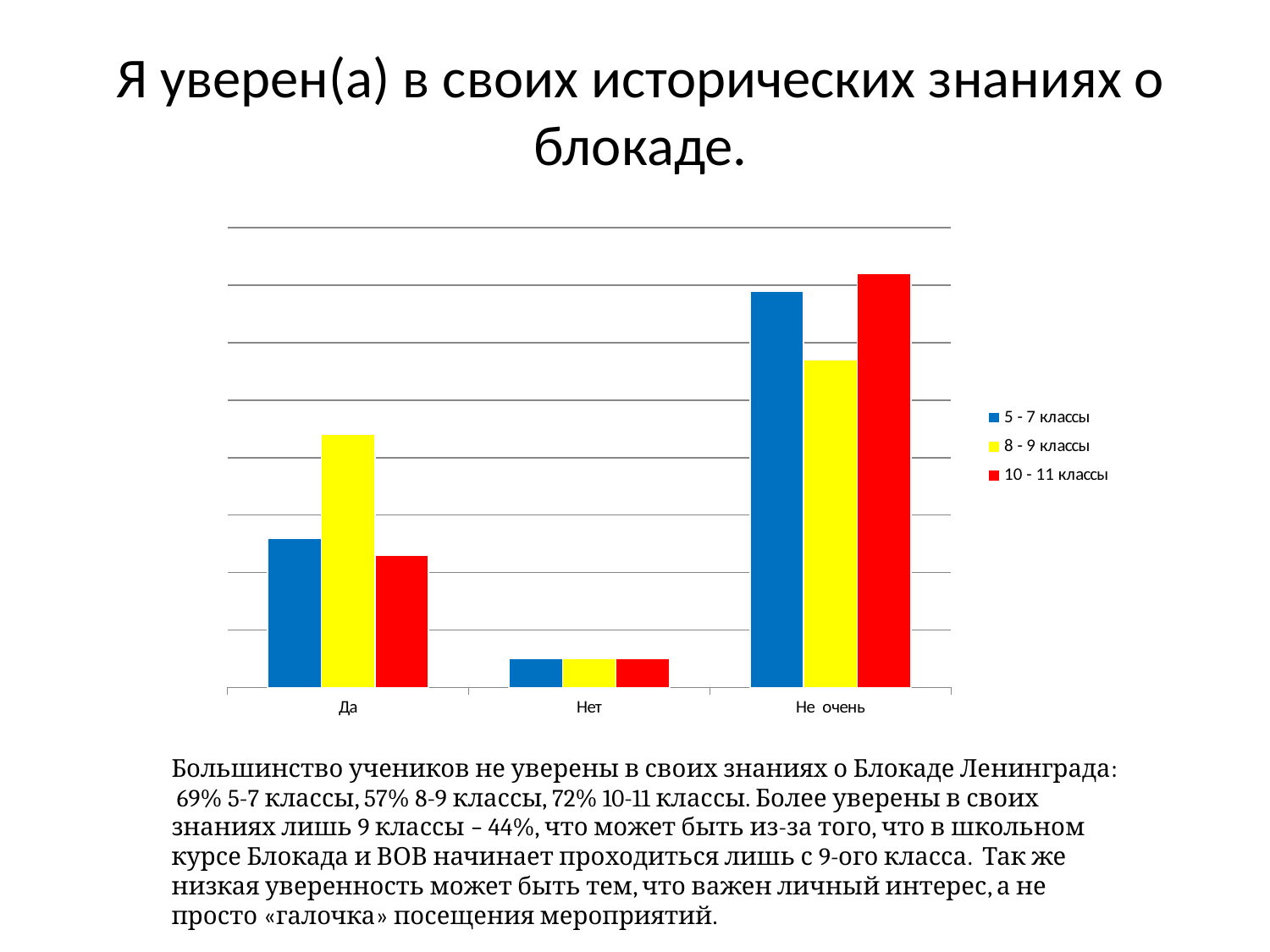
What kind of chart is shown on the slide? bar chart Which colour represents the series 8 - 9 классы in the chart? yellow In the category Да, which series has the highest bar? 8 - 9 классы Which category has the lowest value for the series 10 - 11 классы? Нет How many series does the chart's legend list? 3 In the category Да, which series has the lowest bar? 10 - 11 классы For the category Да, which is larger: the value for 5 - 7 классы or for 8 - 9 классы? 8 - 9 классы In the category Не очень, which series has the highest bar? 10 - 11 классы In the category Не очень, which series has the lowest bar? 8 - 9 классы Which category has the highest value for the series 5 - 7 классы? Не очень How many categories are shown on the x axis of the chart? 3 What is the title of the slide above the chart? Я уверен(а) в своих исторических знаниях о блокаде.